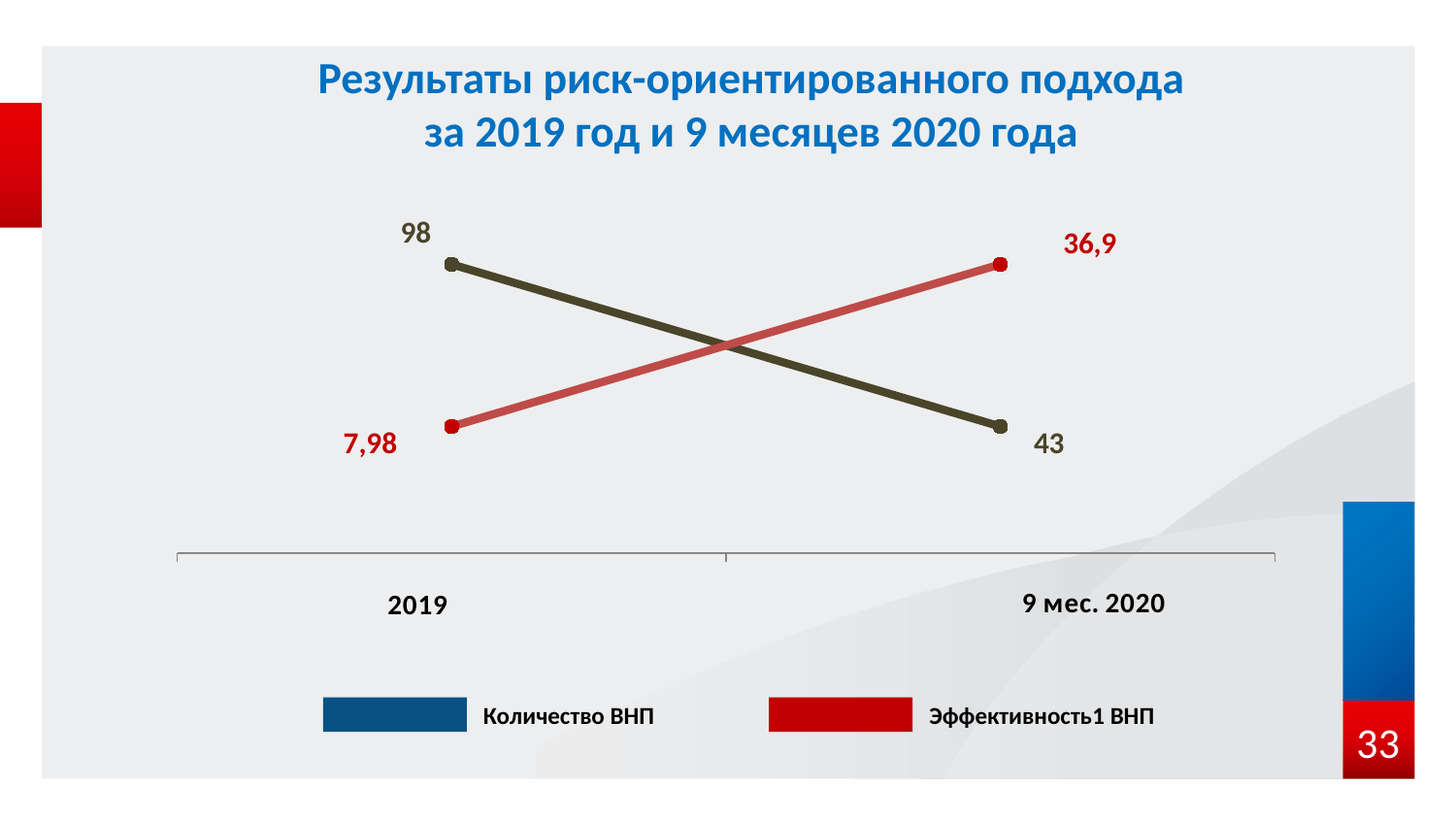
By how much did the Количество ВНП value fall from 2019 to 9 мес. 2020? 55 What value does the Количество ВНП line show for 9 мес. 2020? 43 How many series does the legend list? 2 What value does the Количество ВНП line show for 2019? 98 What value does the Эффективность1 ВНП line show for 9 мес. 2020? 36,9 What value does the Эффективность1 ВНП line show for 2019? 7,98 What kind of chart is shown on the slide? line chart Which is larger: the Количество ВНП value for 2019 or for 9 мес. 2020? 2019 Which is larger: the Эффективность1 ВНП value for 2019 or for 9 мес. 2020? 9 мес. 2020 Does the Эффективность1 ВНП line rise or fall from 2019 to 9 мес. 2020? rise Does the Количество ВНП line rise or fall from 2019 to 9 мес. 2020? fall How many categories are shown on the x axis? 2